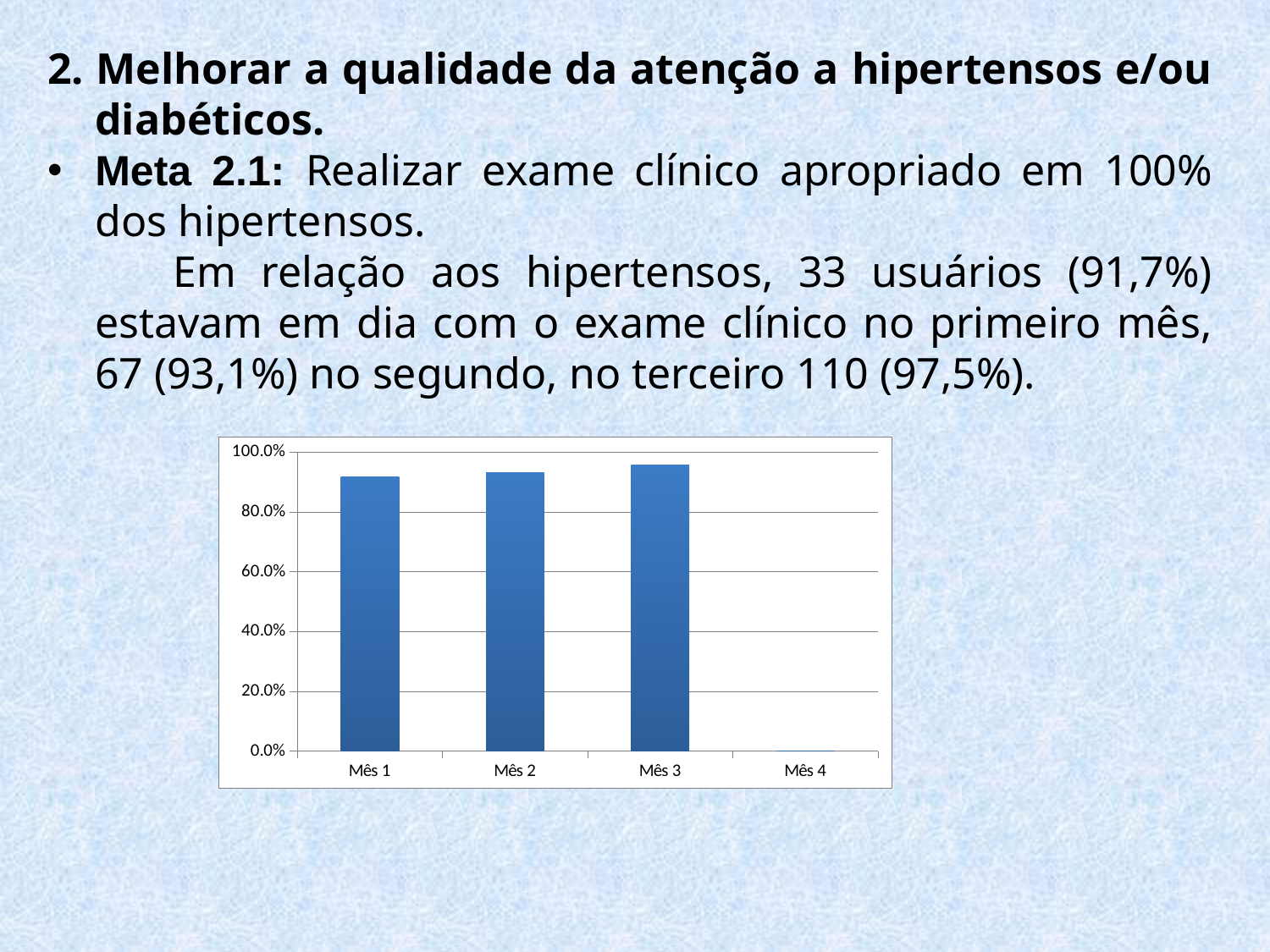
Is the value for Mês 1 greater or less than 80.0%? greater What kind of chart is shown on the slide? bar chart How many categories are shown on the x axis of the chart? 4 Which category on the x axis has no bar plotted? Mês 4 Which month has the tallest bar in the chart? Mês 3 What is the highest tick value shown on the y axis of the chart? 100.0% Do the bar values rise or fall from Mês 1 to Mês 3? rise Is the value for Mês 2 greater or less than 60.0%? greater Which is larger, the value for Mês 1 or the value for Mês 3? Mês 3 Is the value for Mês 3 greater or less than 100.0%? less